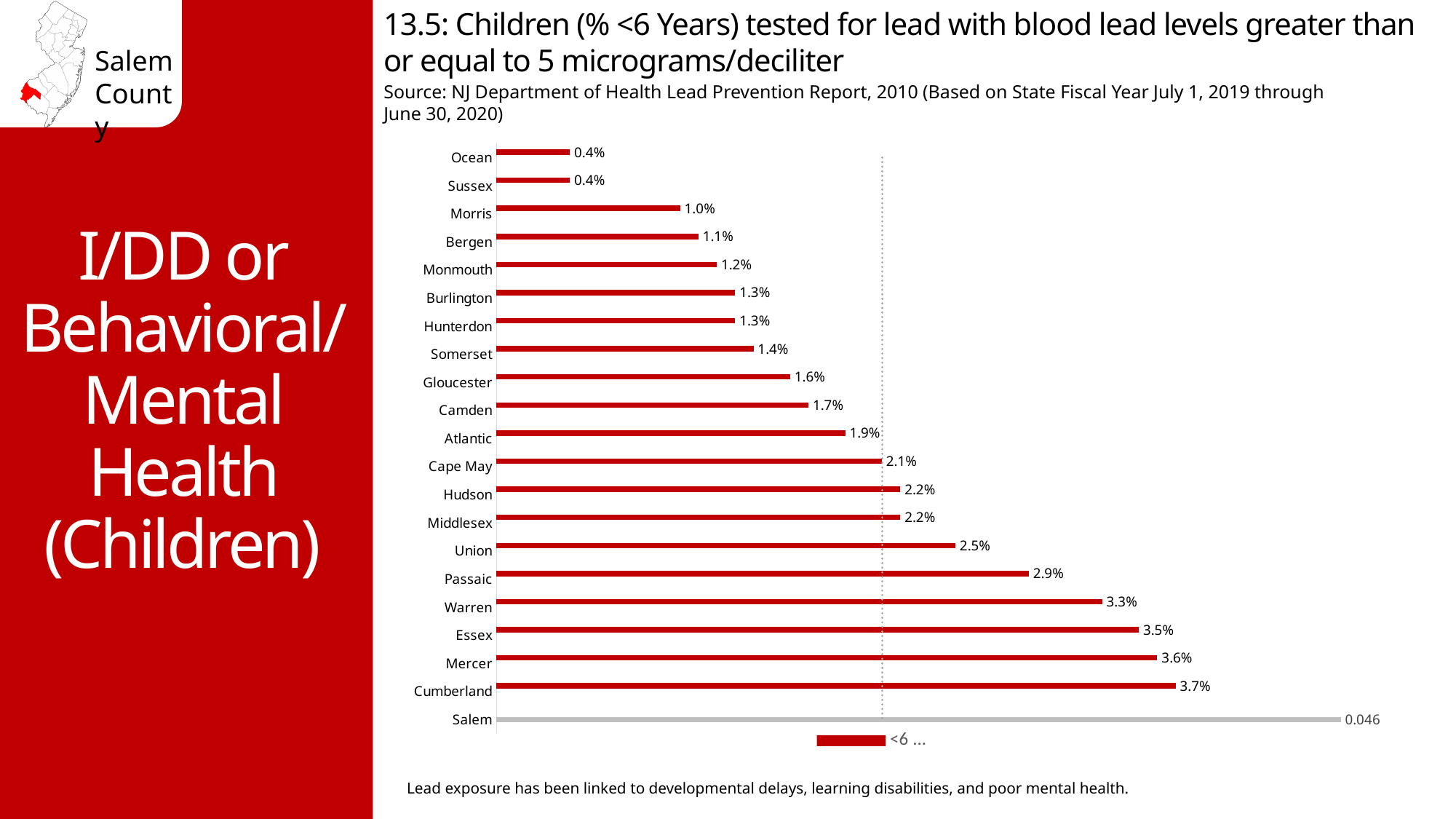
What is the value for Passaic? 2.9% What is the difference between the values for Cumberland and Mercer? 0.1% Which is larger, the value for Morris or the value for Somerset? Somerset Which county has the longest bar in the chart? Salem What kind of chart is shown on the slide? Bar chart How many counties are shown in the chart? 21 What is the value for Cumberland? 3.7% What value is shown for Salem? 0.046 Which is larger, the value for Union or the value for Camden? Union What is the difference between the values for Essex and Warren? 0.2% What colour are the bars for the counties other than Salem? Red What is the value for Gloucester? 1.6%